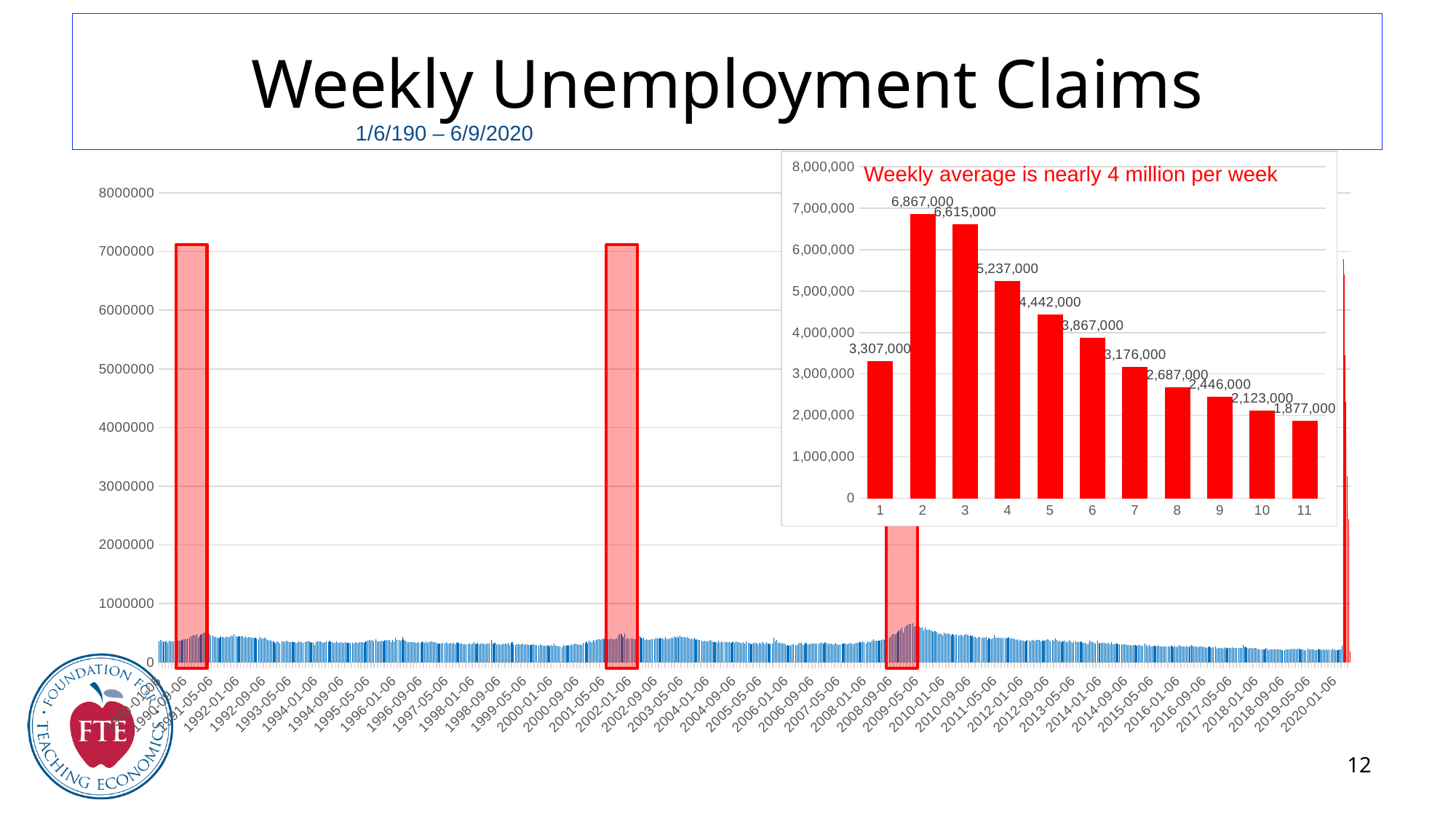
What text is written in red at the top of the inset chart in the upper right? Weekly average is nearly 4 million per week What kind of chart is the inset chart in the upper right? bar chart In the inset chart in the upper right, which category has the highest value? 2 In the inset chart in the upper right, which category has the lowest value? 11 In the inset chart in the upper right, which is larger, the value for category 1 or the value for category 6? category 6 In the inset chart in the upper right, do the values rise or fall from category 2 to category 11? fall In the inset chart in the upper right, what is the value for category 2? 6,867,000 In the inset chart in the upper right, what is the value for category 11? 1,877,000 In the inset chart in the upper right, what is the difference between the values for category 1 and category 11? 1,430,000 In the inset chart in the upper right, what is the value for category 5? 4,442,000 In the inset chart in the upper right, how many bars are plotted? 11 In the inset chart in the upper right, what is the difference between the values for category 2 and category 3? 252,000